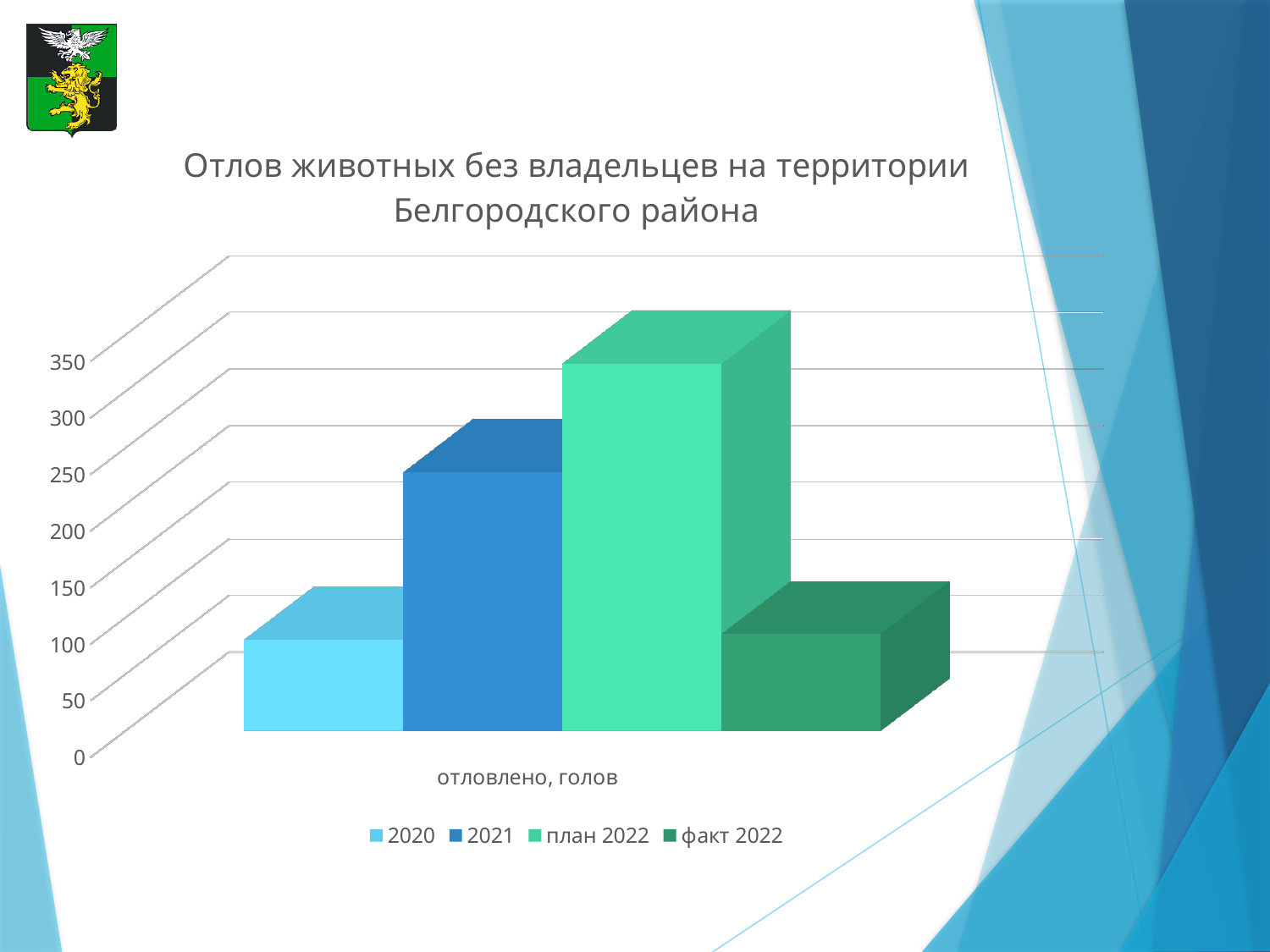
Which series has the highest value? план 2022 Is the value for 2021 greater or less than 200? greater Is the value for 2020 greater or less than 150? less Which is larger, the value for 2021 or the value for 2020? 2021 Is the value for факт 2022 greater or less than 150? less What is the title of the chart? Отлов животных без владельцев на территории Белгородского района Which is larger, the value for план 2022 or the value for факт 2022? план 2022 How many series does the legend list? 4 How many categories are shown on the x axis? 1 What kind of chart is shown on the slide? bar chart What is the label of the category on the x axis? отловлено, голов